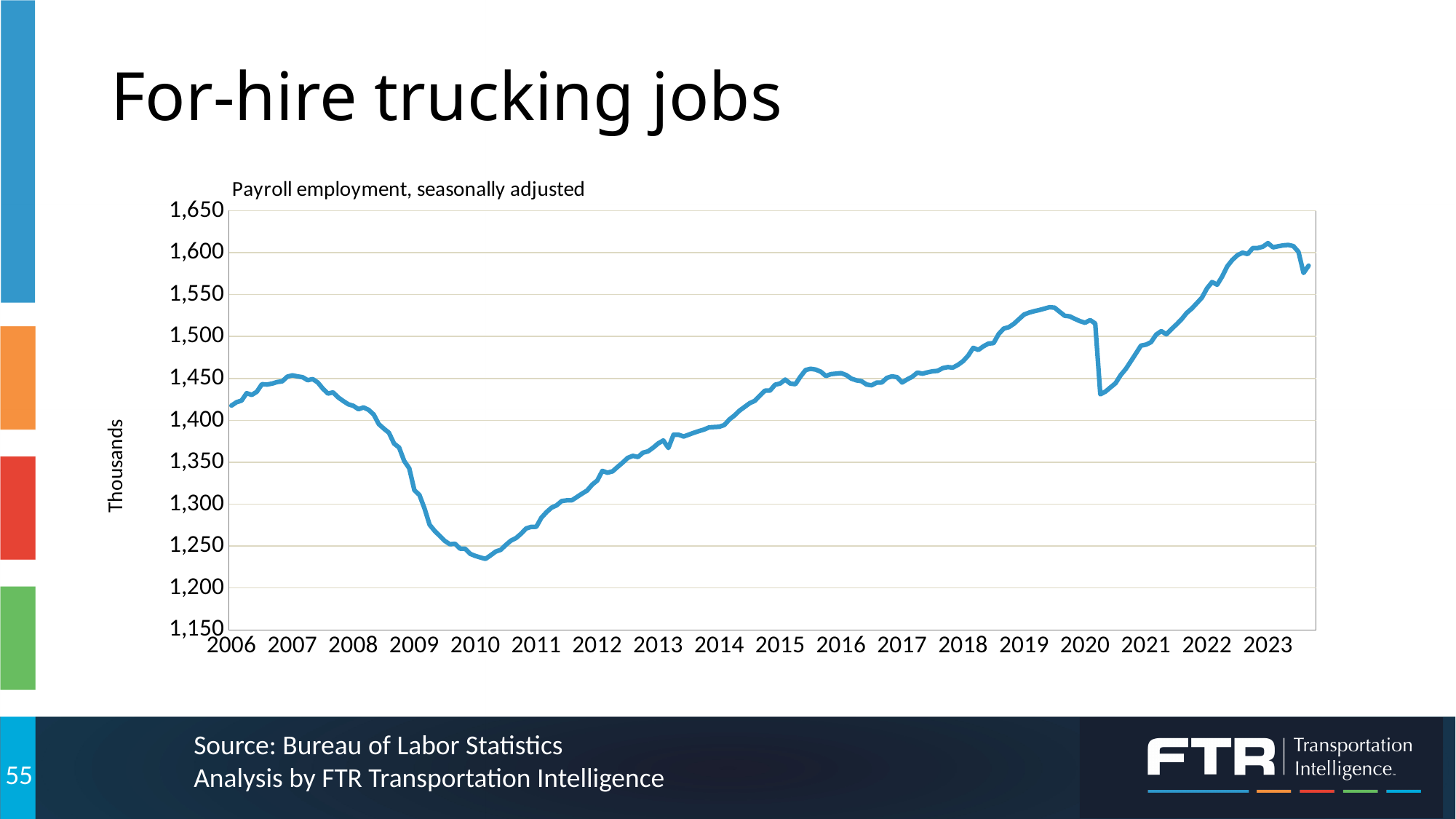
Is the value at the start of 2006 greater or less than 1,350? greater Which is larger, the value at the start of 2019 or the value at the start of 2010? 2019 Is the value at the start of 2023 greater or less than 1,550? greater Between 2010 and 2019, does the line generally rise or fall? rise What is the title printed above the chart? Payroll employment, seasonally adjusted In which year does the line reach its lowest point? 2010 How many year labels are shown on the x axis? 18 Is the lowest point of the line during 2020 greater or less than 1,450? less What is the label on the vertical axis of the chart? Thousands What kind of chart is shown on the slide? line chart Between 2008 and 2010, does the line rise or fall? fall